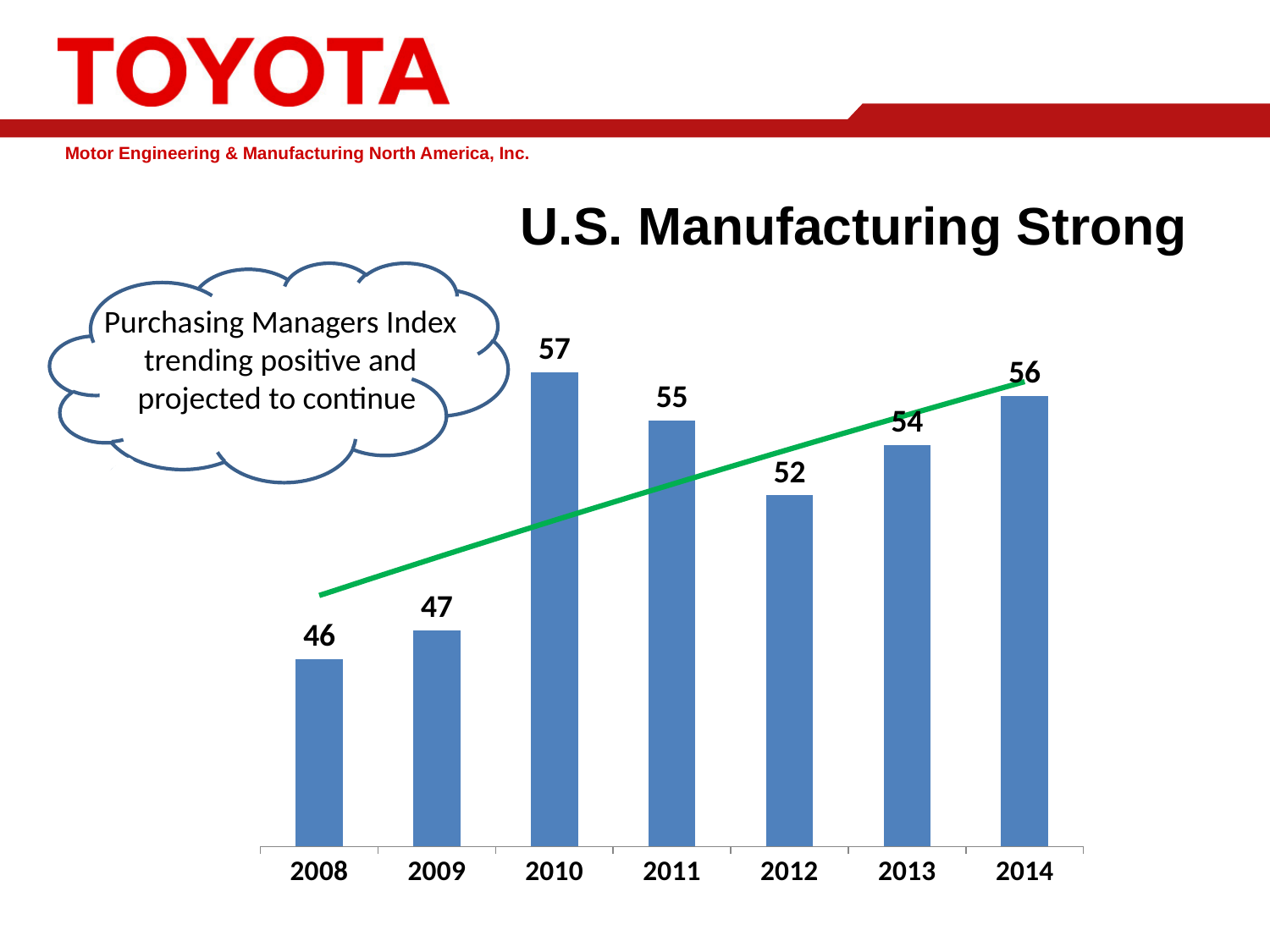
What is the value for 2014? 56 What is the difference between the values for 2014 and 2012? 4 Which is larger, the value for 2011 or the value for 2013? 2011 How many years are shown on the x axis? 7 Do the values rise or fall from 2012 to 2014? rise Which year has the lowest value? 2008 What is the value for 2012? 52 What is the difference between the values for 2010 and 2008? 11 Which year has the highest value? 2010 What is the value for 2008? 46 What kind of chart is shown on the slide? bar chart What is the value for 2010? 57